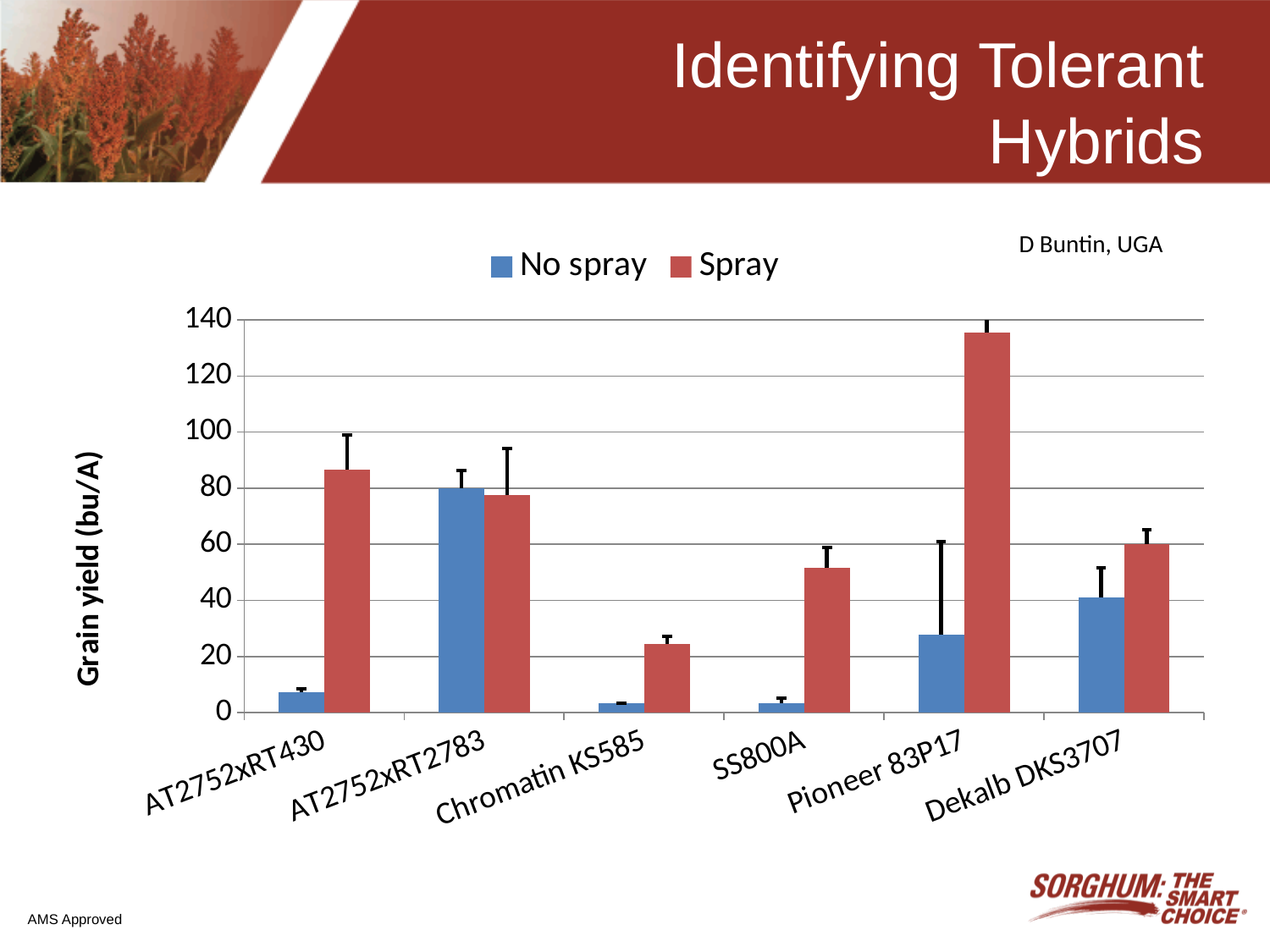
Is the No spray value for AT2752xRT2783 greater or less than 60? greater Which hybrid has the highest No spray grain yield? AT2752xRT2783 What is the label of the y axis? Grain yield (bu/A) How many series does the legend list? 2 Which hybrid has the lowest Spray grain yield? Chromatin KS585 What kind of chart is shown on the slide? bar chart Is the Spray value for AT2752xRT430 greater or less than 100? less For Dekalb DKS3707, which is larger, the No spray value or the Spray value? Spray Is the Spray value for SS800A greater or less than 60? less Which hybrid has the highest Spray grain yield? Pioneer 83P17 How many hybrids are shown on the x axis? 6